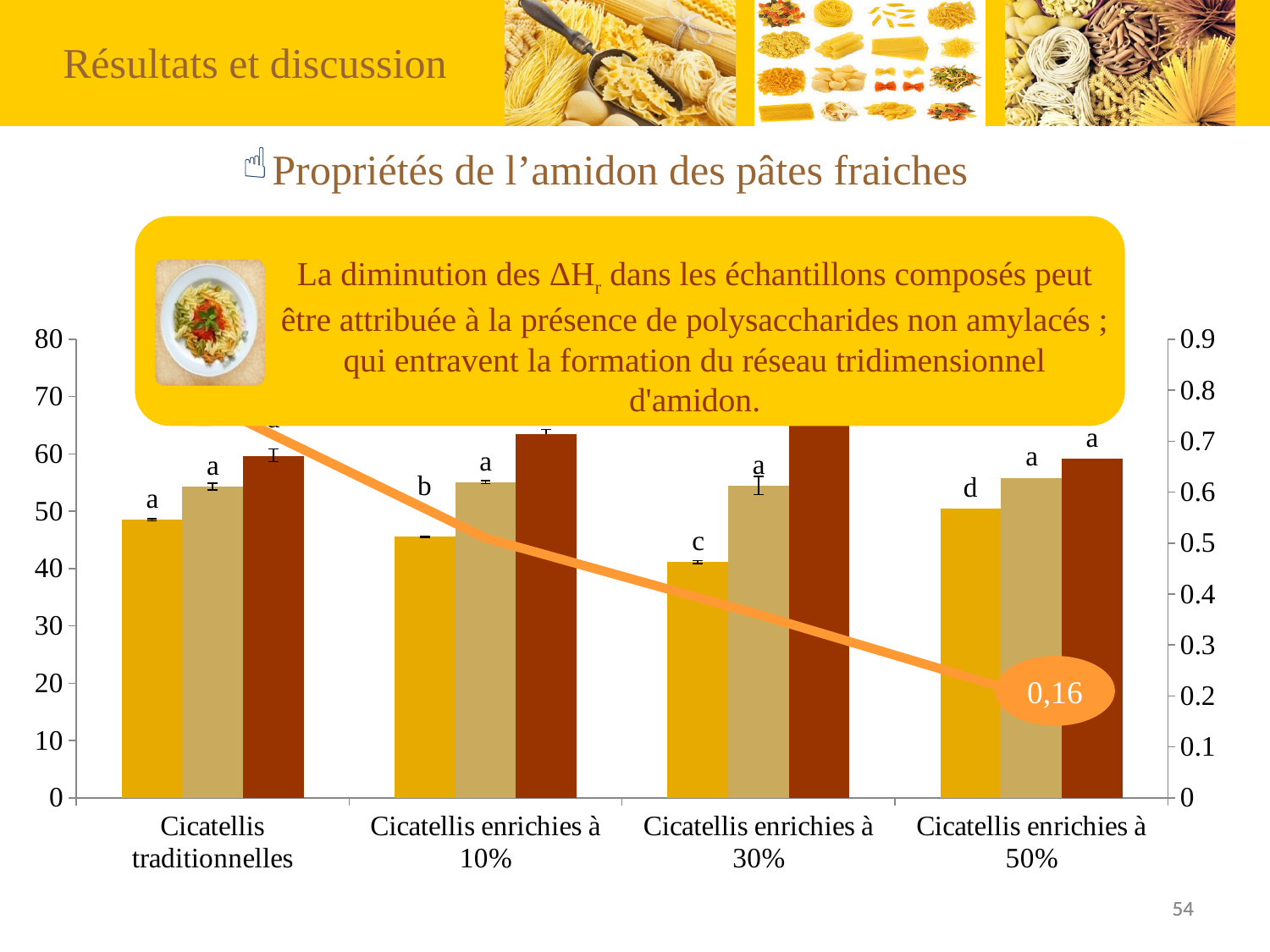
Within the Cicatellis traditionnelles group, which coloured bar is the tallest? dark red How many categories are shown on the x axis of the chart? 4 What value is labelled on the orange line at Cicatellis enrichies à 50%? 0,16 Which is larger: the dark red bar for Cicatellis enrichies à 30% or the dark red bar for Cicatellis enrichies à 50%? Cicatellis enrichies à 30% Which is larger: the yellow bar for Cicatellis traditionnelles or the yellow bar for Cicatellis enrichies à 30%? Cicatellis traditionnelles What kind of chart is shown on the slide? combination bar and line chart Does the orange line rise or fall from left to right across the categories? fall Is the value of the yellow bar for Cicatellis traditionnelles greater or less than 40? greater Is the value of the yellow bar for Cicatellis enrichies à 50% greater or less than 60? less Among the yellow bars, which category has the lowest value? Cicatellis enrichies à 30% Is the value of the dark red bar for Cicatellis enrichies à 30% greater or less than 60? greater What is the maximum value shown on the right-hand vertical axis? 0.9